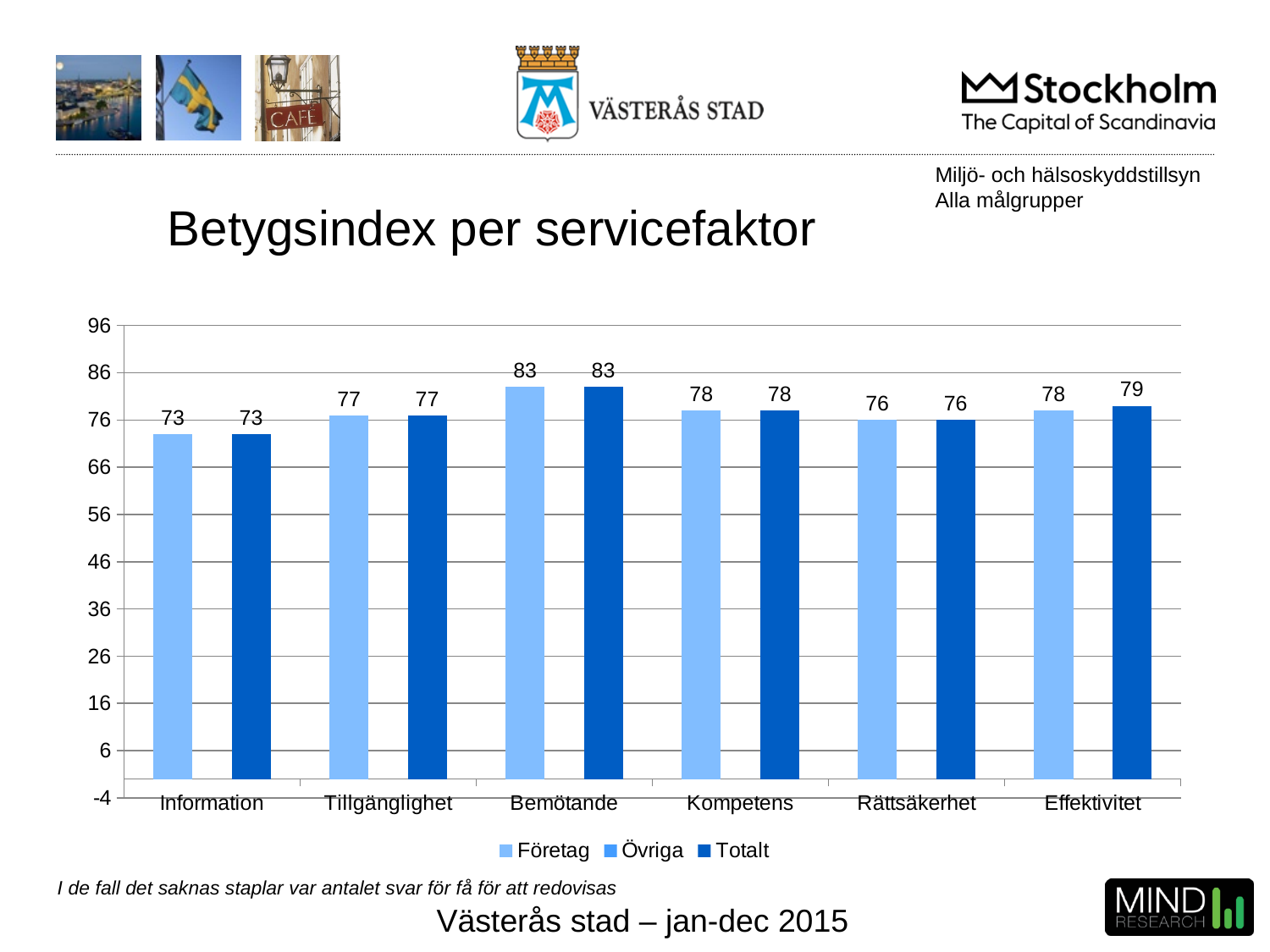
What is the Totalt value for Bemötande? 83 What is the Företag value for Effektivitet? 78 How many service factors are shown on the x axis? 6 What kind of chart is shown on the slide? Bar chart Which service factor has the highest Totalt value? Bemötande What is the difference between the Totalt and Företag values for Effektivitet? 1 How many series does the legend list? 3 What is the difference between the Totalt values for Bemötande and Information? 10 What is the title of the chart? Betygsindex per servicefaktor What is the Totalt value for Information? 73 Which is larger, the Totalt value for Tillgänglighet or the Totalt value for Rättsäkerhet? Tillgänglighet Which service factor has the lowest Företag value? Information